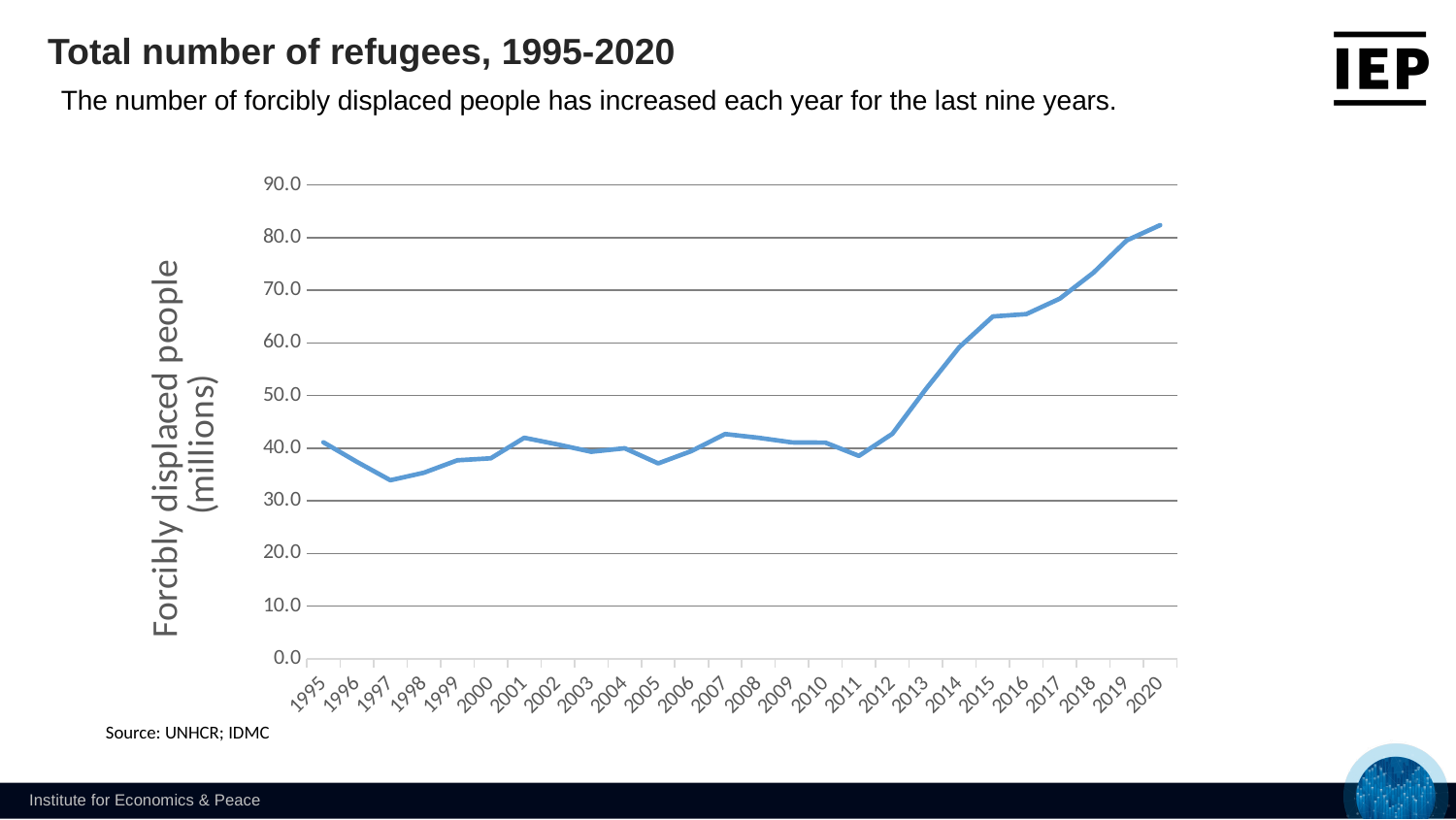
What is the title of the chart? Total number of refugees, 1995-2020 Which year has the lowest number of forcibly displaced people? 1997 How many years are plotted along the x axis of the chart? 26 Is the value for 2012 greater or less than 50.0? less What kind of chart is shown on the slide? line chart Is the value for 2020 greater or less than 80.0? greater Which year has the highest number of forcibly displaced people? 2020 What is the label on the vertical axis of the chart? Forcibly displaced people (millions) Is the value for 2015 greater or less than 60.0? greater Do the values generally rise or fall from 2011 to 2020? rise Which year has a larger value, 1995 or 2020? 2020